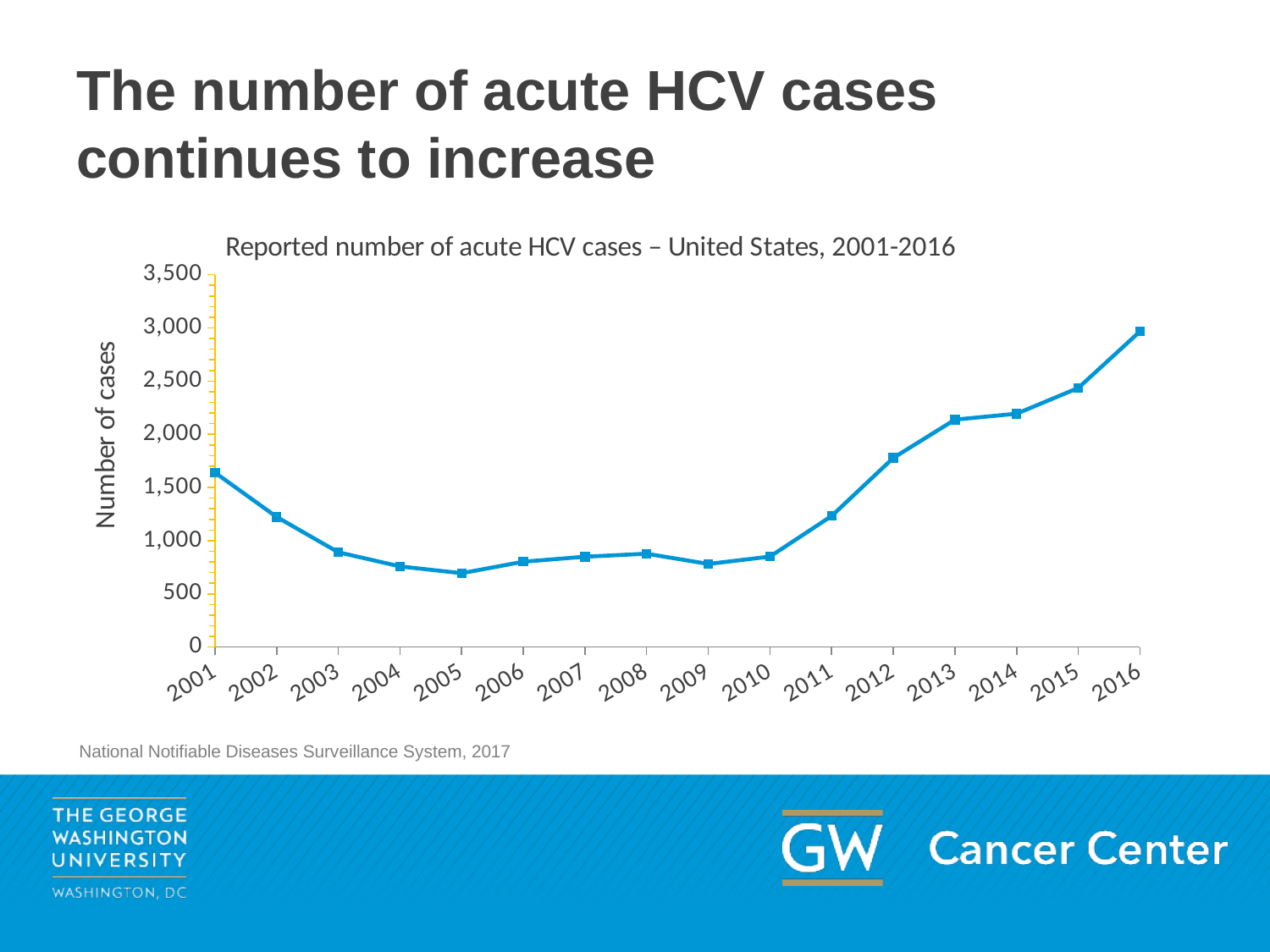
Is the value for 2001 greater or less than 1,500? greater Which year has the lowest number of reported acute HCV cases? 2005 How many years are plotted on the x axis of the chart? 16 What kind of chart is shown on the slide? line chart Is the value for 2005 greater or less than 1,000? less Do the values rise or fall from 2010 to 2016? rise Which year has more reported acute HCV cases, 2001 or 2011? 2001 Which year has the highest number of reported acute HCV cases? 2016 What is the label on the vertical axis of the chart? Number of cases What is the title of the chart? Reported number of acute HCV cases – United States, 2001-2016 Is the value for 2016 greater or less than 2,500? greater